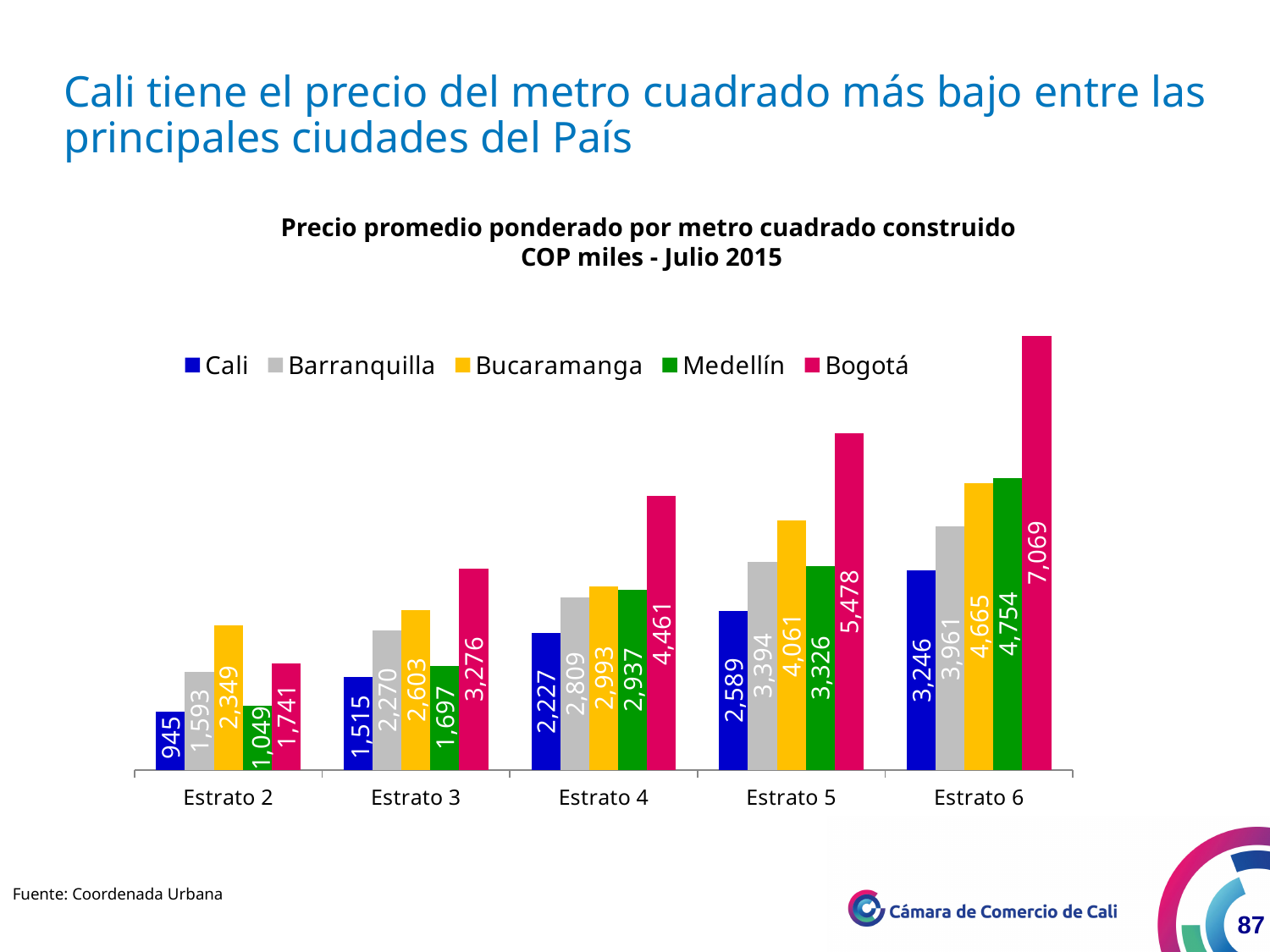
How many estrato categories are shown on the x axis? 5 What is the value for Bogotá in Estrato 6? 7,069 Do the values for Cali rise or fall from Estrato 2 to Estrato 6? Rise How many series does the legend list? 5 What is the value for Bucaramanga in Estrato 5? 4,061 What is the difference between Bogotá and Cali in Estrato 5? 2,889 What is the value for Cali in Estrato 2? 945 What is the value for Medellín in Estrato 3? 1,697 Which city has the highest value in Estrato 4? Bogotá What kind of chart is shown on the slide? Bar chart Which is larger in Estrato 2: Bucaramanga or Bogotá? Bucaramanga Which city has the lowest value in Estrato 6? Cali